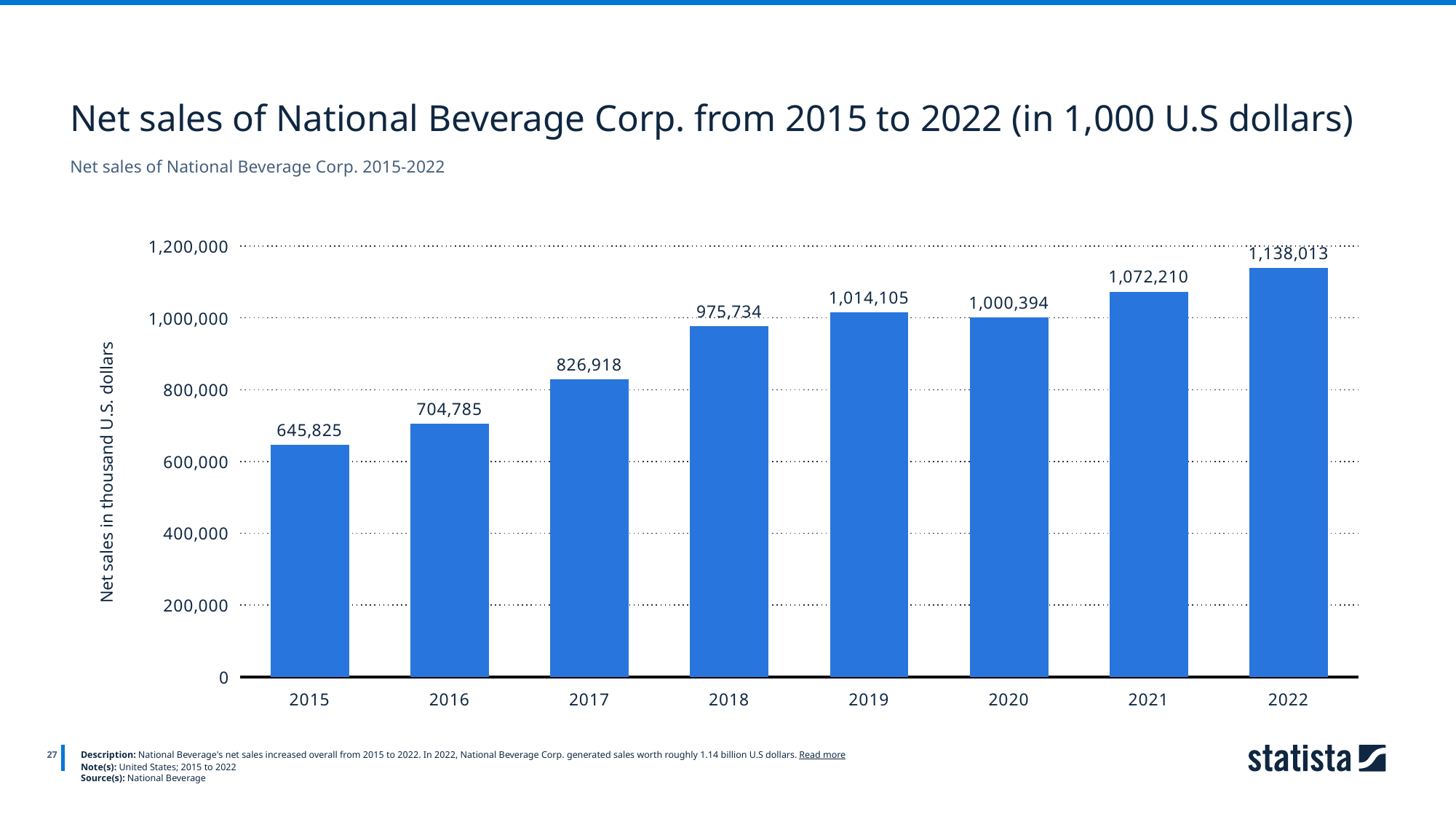
What is the difference in net sales between 2017 and 2016? 122,133 What kind of chart is shown on the slide? Bar chart What were the net sales of National Beverage Corp. in 2015? 645,825 What were the net sales of National Beverage Corp. in 2018? 975,734 Do net sales generally rise or fall from 2015 to 2022? Rise What is the label of the y-axis? Net sales in thousand U.S. dollars Is the value for 2017 greater or less than 800,000? greater Were net sales higher in 2019 or in 2020? 2019 What is the difference in net sales between 2022 and 2021? 65,803 Which year had the highest net sales? 2022 Which year had the lowest net sales? 2015 How many years are shown on the chart? 8